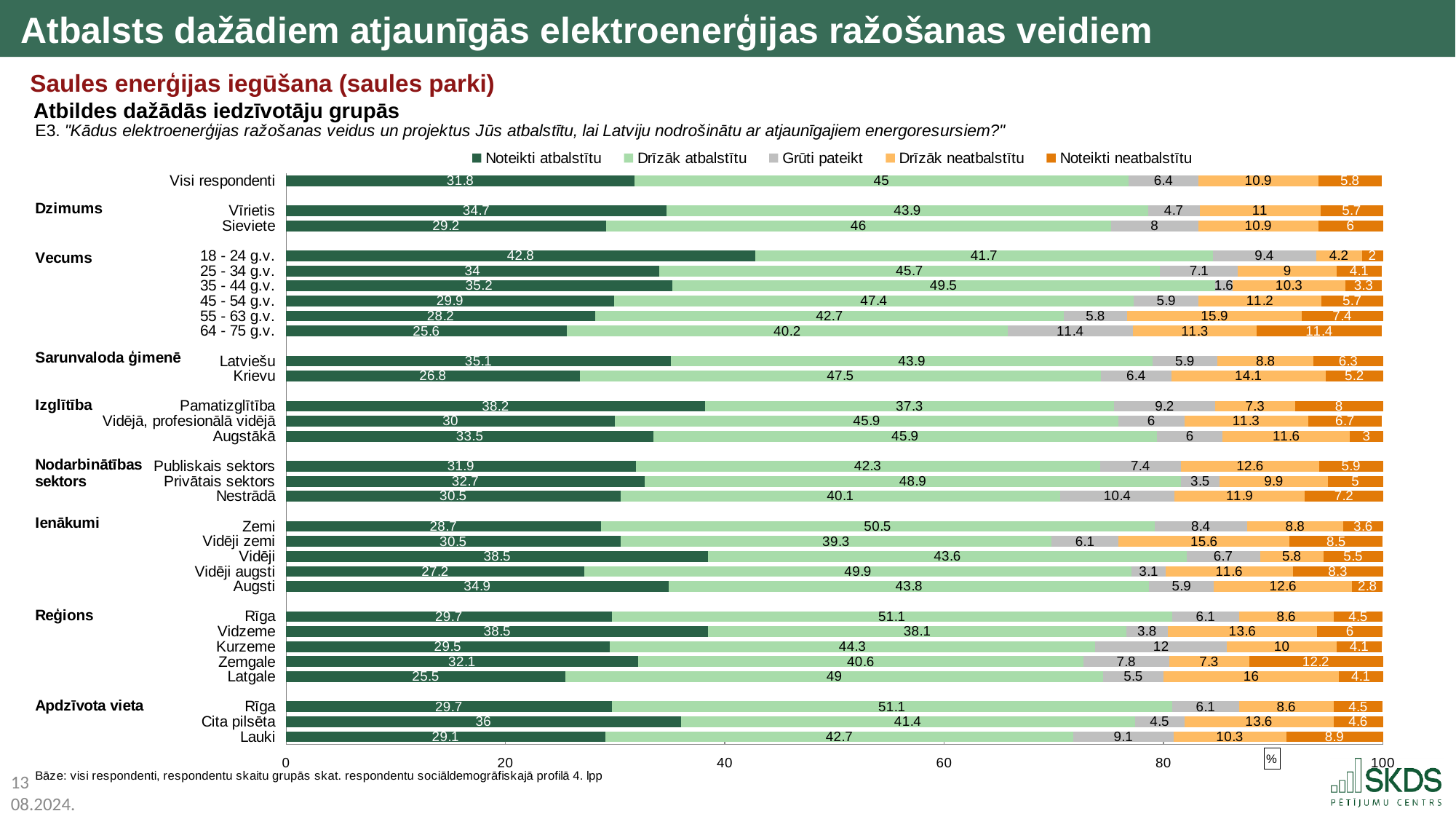
Which group has the highest 'Noteikti atbalstītu' value? 18 - 24 g.v. What is the difference between the 'Noteikti atbalstītu' values for Vīrietis and Sieviete? 5.5 What is the 'Noteikti atbalstītu' value for Visi respondenti? 31.8 What is the 'Grūti pateikt' value for 64 - 75 g.v.? 11.4 How many groups (bars) are plotted in the chart? 30 What kind of chart is shown on the slide? Stacked bar chart What is the 'Drīzāk neatbalstītu' value for Latgale? 16 How many series does the legend list? 5 Which group has the highest 'Noteikti neatbalstītu' value? Zemgale Which has a larger 'Noteikti atbalstītu' value, Latviešu or Krievu? Latviešu What is the 'Noteikti atbalstītu' value for Pamatizglītība? 38.2 What is the total of the stacked bar for Visi respondenti? 99.9